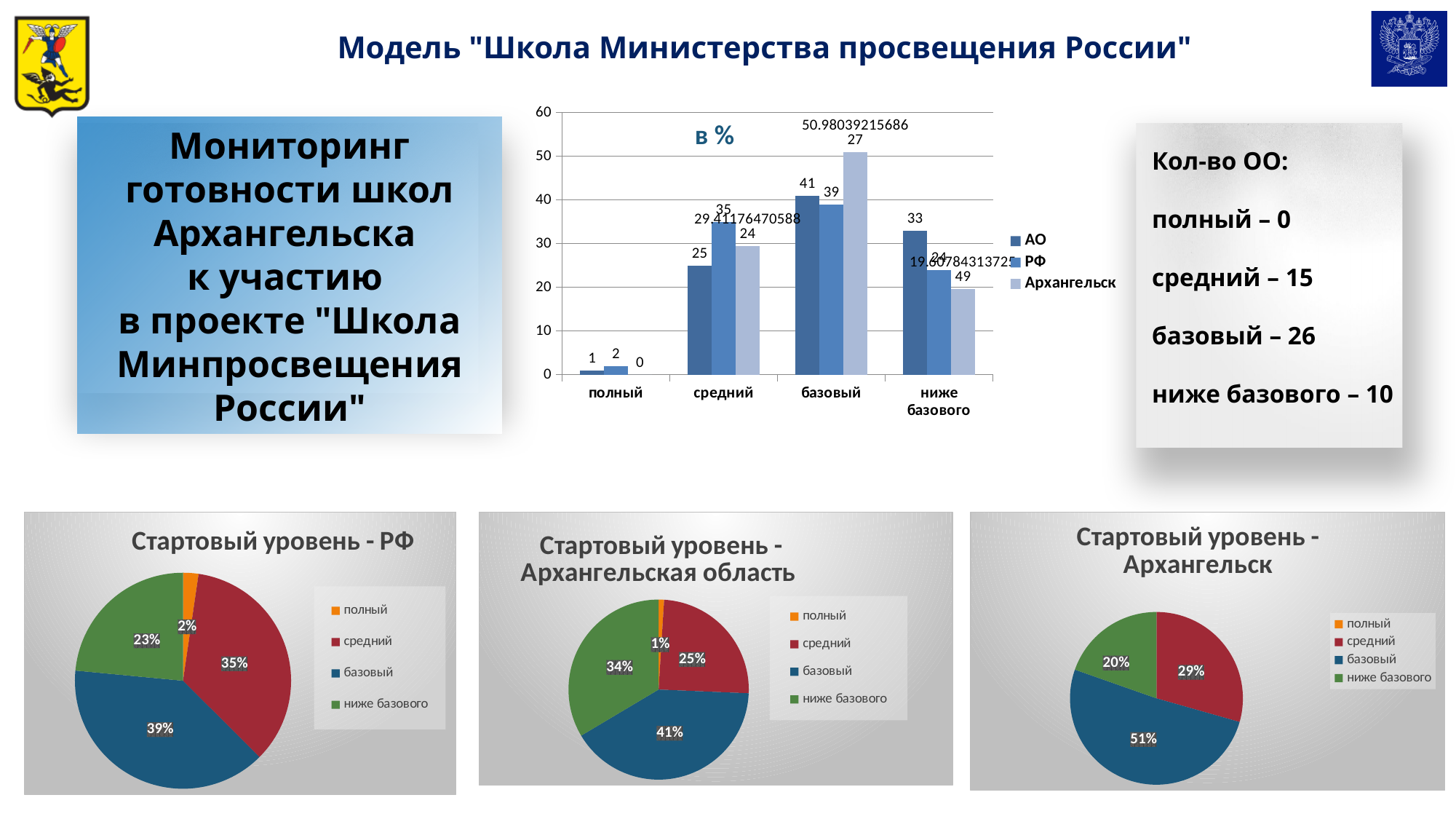
In the pie chart 'Стартовый уровень - Архангельская область', which category has the largest slice? базовый What kind of chart is the chart at the top center of the slide? bar chart In the pie chart 'Стартовый уровень - РФ', which category has the smallest slice? полный How many entries does the legend of the pie chart 'Стартовый уровень - Архангельск' list? 4 In the bar chart at the top of the slide, what is the difference between the АО and РФ values in the ниже базового category? 9 In the bar chart at the top of the slide, what is the value for РФ in the средний category? 35 In the pie chart 'Стартовый уровень - РФ', what share does базовый have? 39% In the bar chart at the top of the slide, what is the value for АО in the базовый category? 41 In the bar chart at the top of the slide, which is larger in the базовый category, АО or РФ? АО In the bar chart at the top of the slide, what is the value for Архангельск in the полный category? 0 How many series does the legend of the bar chart at the top of the slide list? 3 In the pie chart 'Стартовый уровень - Архангельск', what share does средний have? 29%